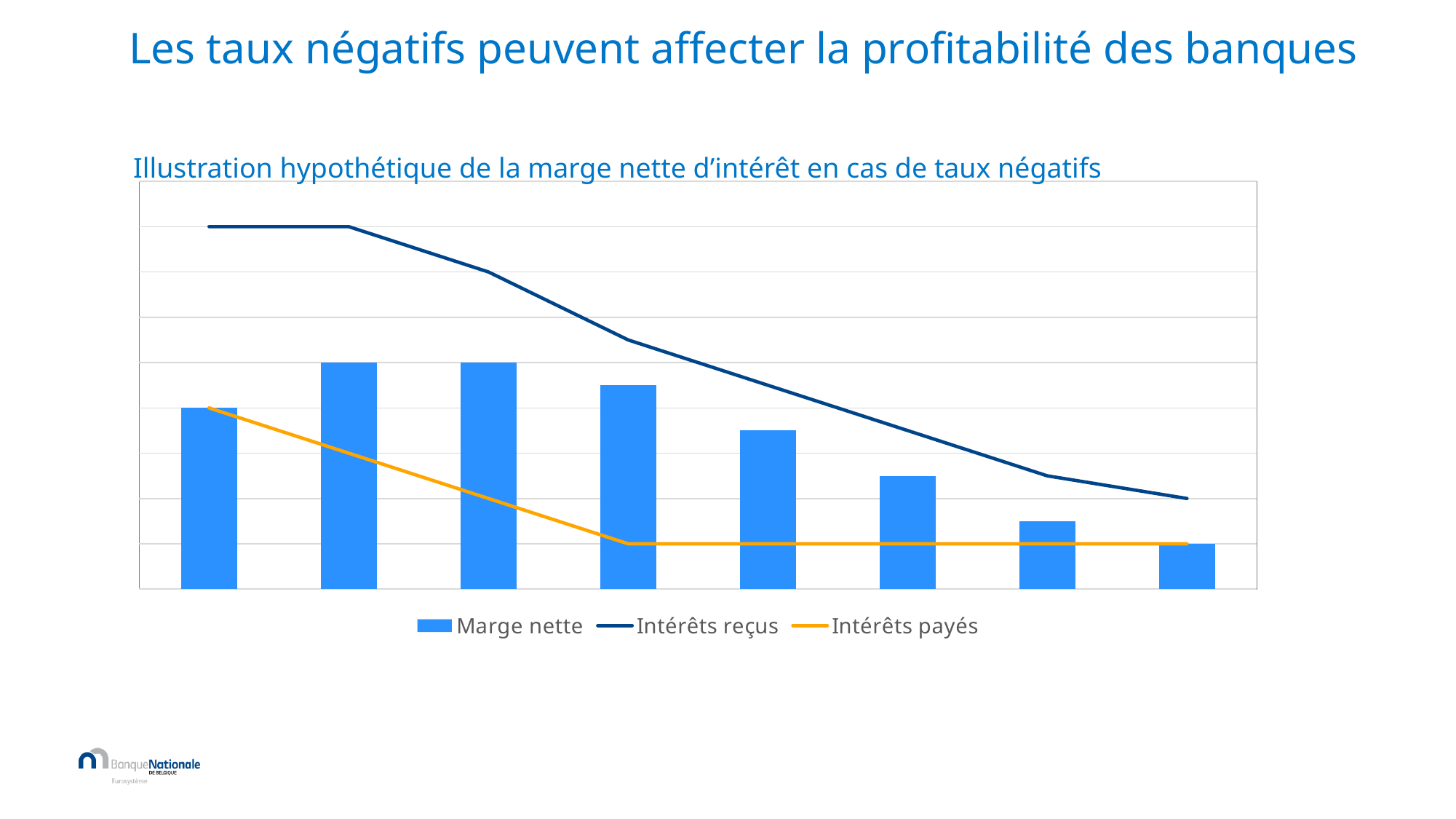
How many bars are plotted for Marge nette? 8 What is the title of the chart? Illustration hypothétique de la marge nette d'intérêt en cas de taux négatifs Which series is drawn as bars? Marge nette Does the Intérêts payés line rise or fall over the first four points? It falls How many series does the legend list? 3 Does the Intérêts reçus line rise or fall along the x axis? It falls Do the Marge nette bars rise or fall from the third bar to the last bar? They fall What kind of chart is shown on the slide? A combined bar and line chart Which is taller, the first Marge nette bar or the last Marge nette bar? The first bar